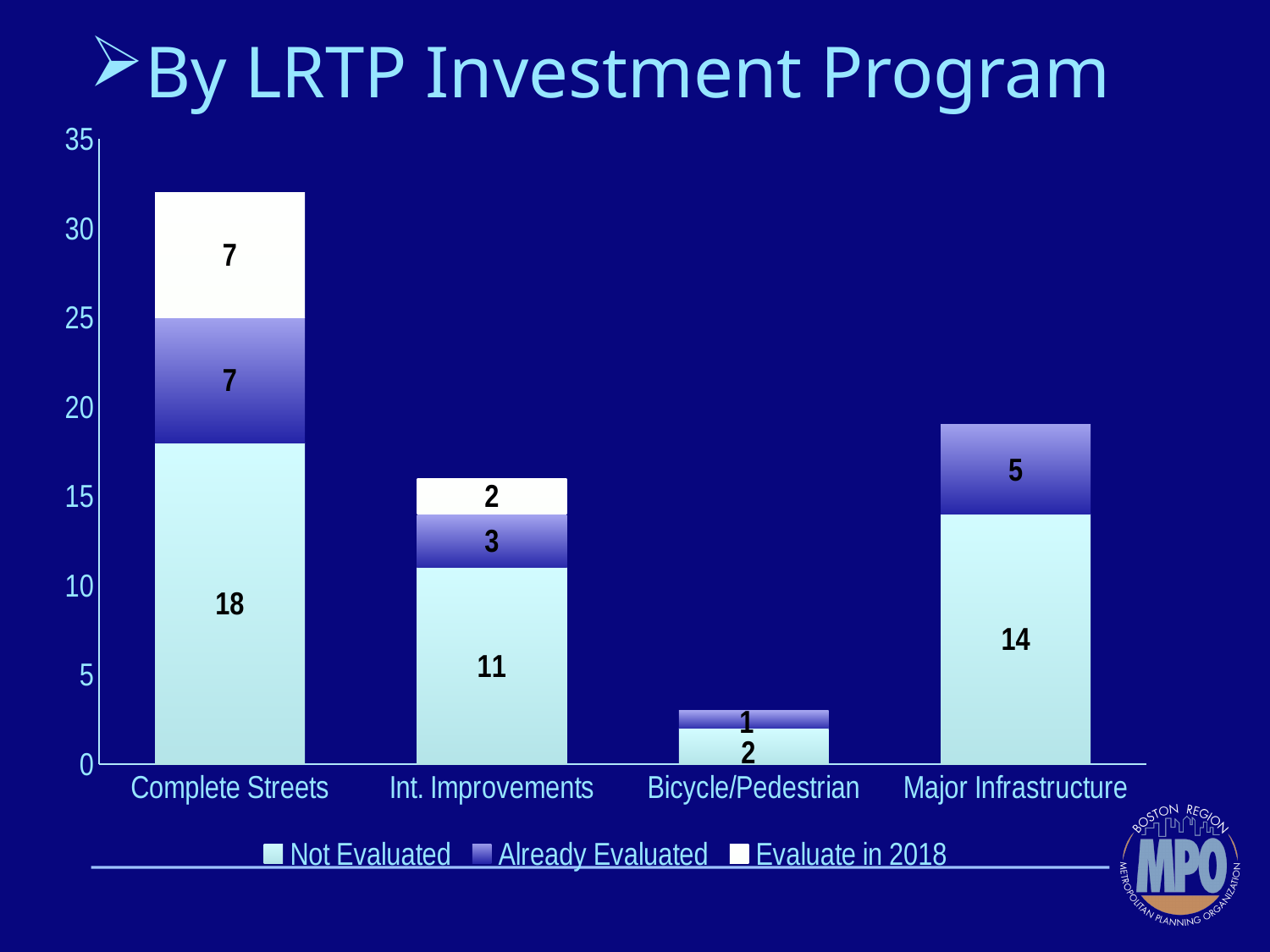
What type of chart is shown on the slide? Stacked bar chart What is the Evaluate in 2018 value for Int. Improvements? 2 What is the Not Evaluated value for Complete Streets? 18 What is the total of the stacked bar for Complete Streets? 32 What is the Already Evaluated value for Major Infrastructure? 5 What is the difference between the Not Evaluated values for Complete Streets and Major Infrastructure? 4 Which category has the shortest stacked bar? Bicycle/Pedestrian Which is larger, the Already Evaluated value for Int. Improvements or for Major Infrastructure? Major Infrastructure What is the Not Evaluated value for Bicycle/Pedestrian? 2 What is the total of the stacked bar for Int. Improvements? 16 How many series does the legend list? 3 Which category has the tallest stacked bar? Complete Streets